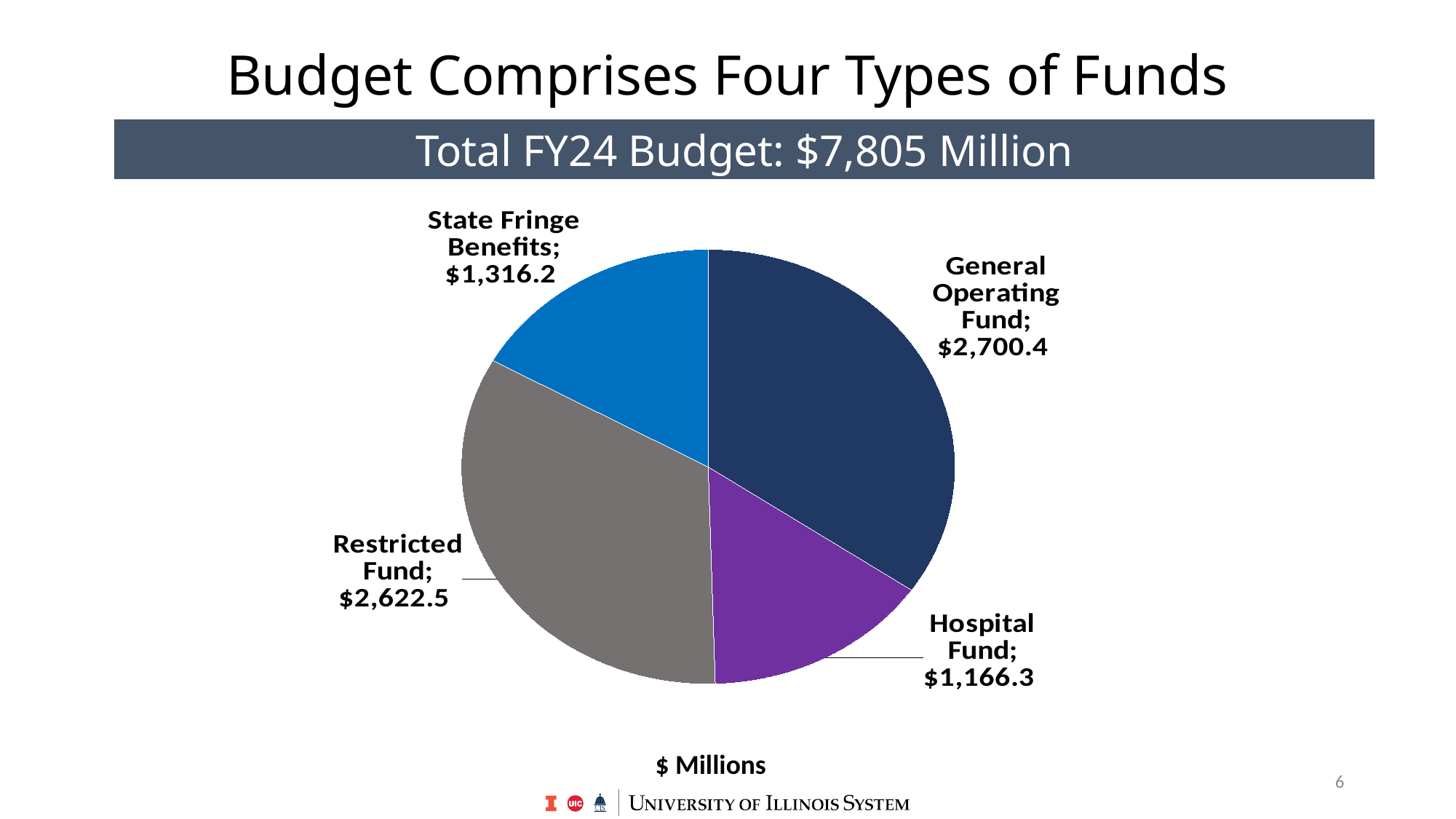
What is the difference between State Fringe Benefits and the Hospital Fund? $149.9 What is the value for State Fringe Benefits? $1,316.2 What unit is stated below the pie chart? $ Millions How many slices does the pie chart have? 4 Which fund type has the largest value? General Operating Fund What is the difference between the General Operating Fund and the Restricted Fund? $77.9 What is the value for the Hospital Fund? $1,166.3 What is the value for the Restricted Fund? $2,622.5 Which is larger, the Hospital Fund or State Fringe Benefits? State Fringe Benefits Which fund type has the smallest value? Hospital Fund What type of chart is shown on the slide? Pie chart What is the value for the General Operating Fund? $2,700.4